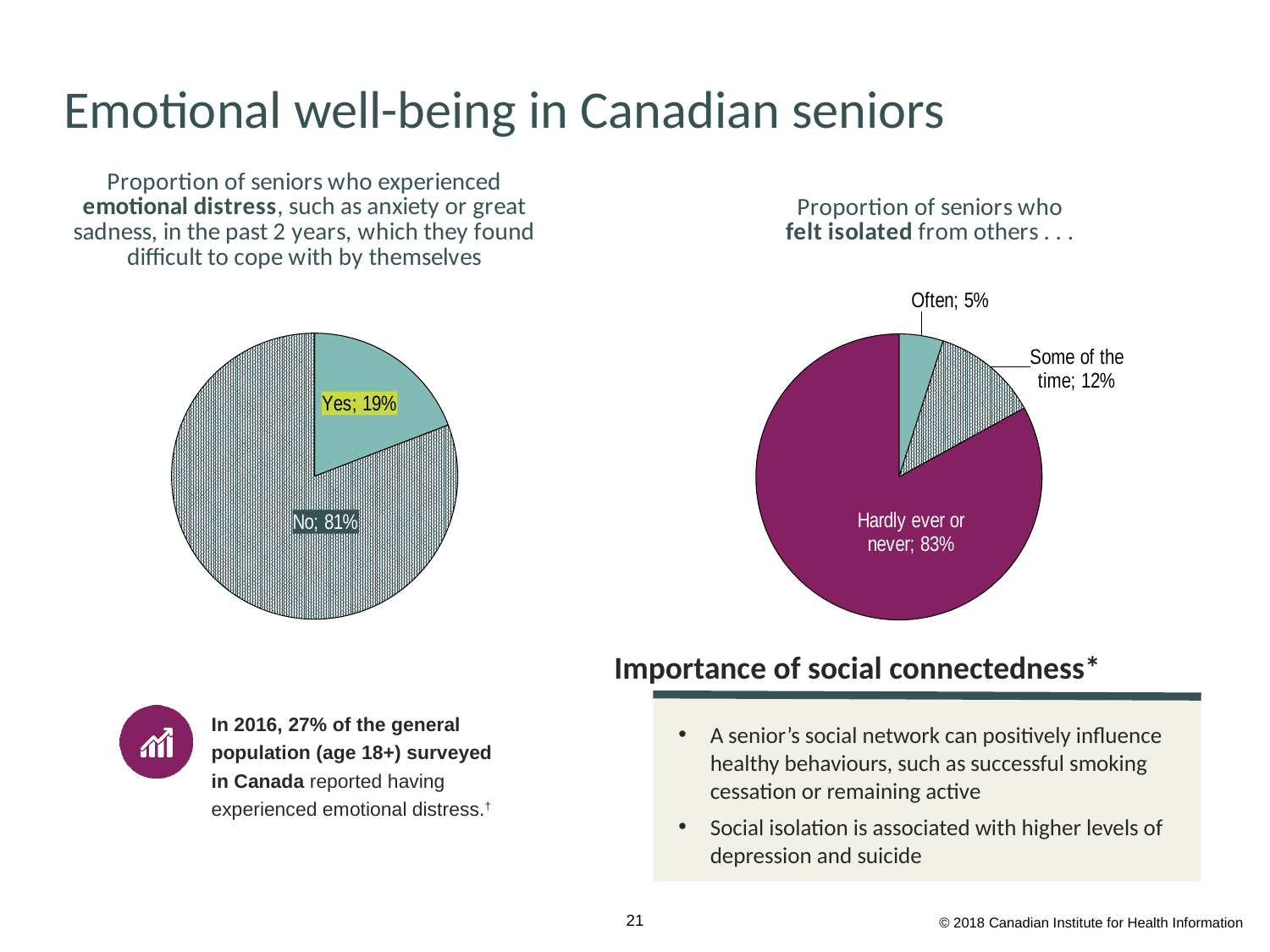
In the felt isolated pie chart on the right, what percentage of seniors felt isolated some of the time? 12% In the emotional distress pie chart on the left, what is the difference in percentage points between No and Yes? 62 In the felt isolated pie chart on the right, which category has the largest share? Hardly ever or never What type of chart is used for the emotional distress data on the left? Pie chart How many slices does the felt isolated pie chart on the right have? 3 In the felt isolated pie chart on the right, which category has the smallest share? Often In the felt isolated pie chart on the right, what is the difference in percentage points between Some of the time and Often? 7 In the emotional distress pie chart on the left, what percentage of seniors answered Yes? 19% In the felt isolated pie chart on the right, what percentage of seniors felt isolated hardly ever or never? 83% In the felt isolated pie chart on the right, what percentage of seniors felt isolated often? 5% In the emotional distress pie chart on the left, what percentage of seniors answered No? 81% In the felt isolated pie chart on the right, which is larger: Often or Some of the time? Some of the time